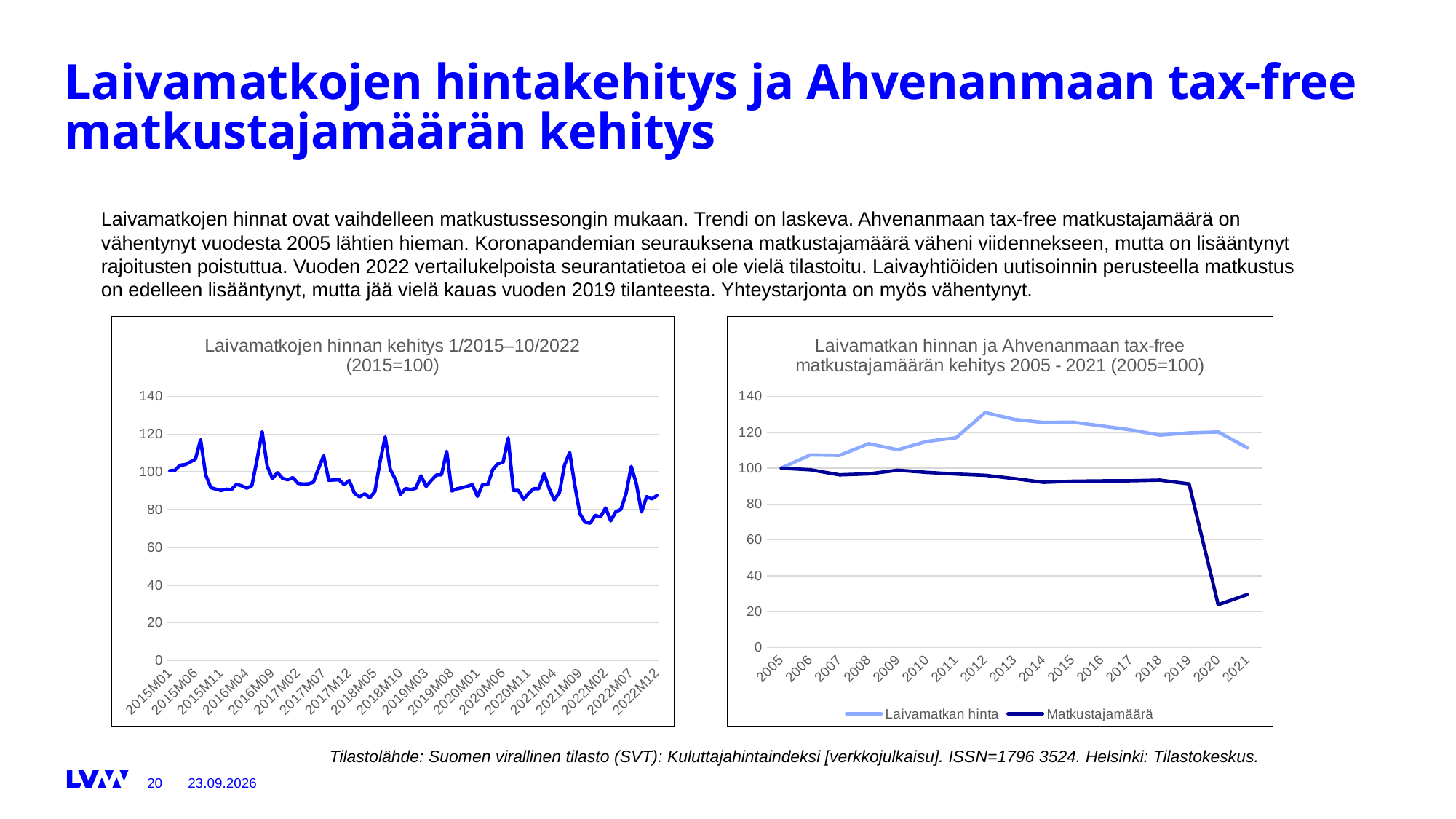
In the right chart, which year has the lowest value for Matkustajamäärä? 2020 What kind of chart is the left chart, 'Laivamatkojen hinnan kehitys 1/2015–10/2022 (2015=100)'? line chart In the right chart, which series has the larger value in 2021, Laivamatkan hinta or Matkustajamäärä? Laivamatkan hinta In the right chart, does the Matkustajamäärä series rise or fall overall from 2005 to 2021? fall In the right chart, which series is drawn in the darker blue line? Matkustajamäärä In the right chart, is the value for Laivamatkan hinta in 2012 greater or less than 120? greater In the right chart, which year has the highest value for Laivamatkan hinta? 2012 How many years are shown on the x axis of the right chart? 17 In the right chart, is the value for Matkustajamäärä in 2020 greater or less than 40? less How many series does the legend of the right chart list? 2 What kind of chart is the right chart, 'Laivamatkan hinnan ja Ahvenanmaan tax-free matkustajamäärän kehitys 2005 - 2021 (2005=100)'? line chart